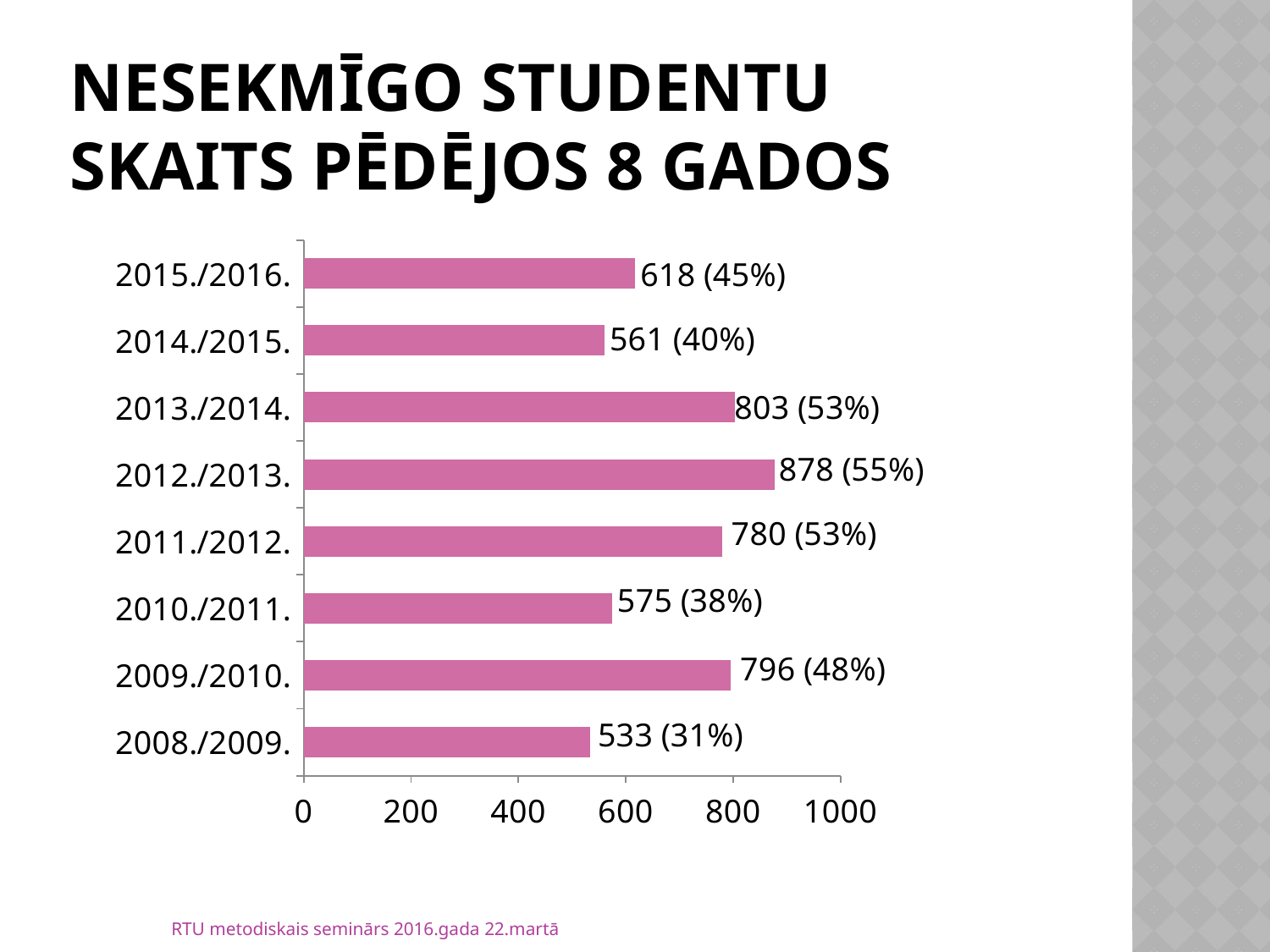
Which academic year has the highest number of unsuccessful students? 2012./2013. How many academic years are shown on the chart? 8 Which academic year has the lowest number of unsuccessful students? 2008./2009. What is the data label for 2015./2016.? 618 (45%) What is the title of the slide? NESEKMĪGO STUDENTU SKAITS PĒDĒJOS 8 GADOS Is the value for 2010./2011. greater or less than 600? less What is the difference between the number of students in 2013./2014. and 2014./2015.? 242 What is the data label for 2012./2013.? 878 (55%) What is the data label for 2008./2009.? 533 (31%) What kind of chart is shown on the slide? bar chart What is the difference between the number of students in 2012./2013. and 2008./2009.? 345 Which is larger, the value for 2009./2010. or the value for 2011./2012.? 2009./2010.